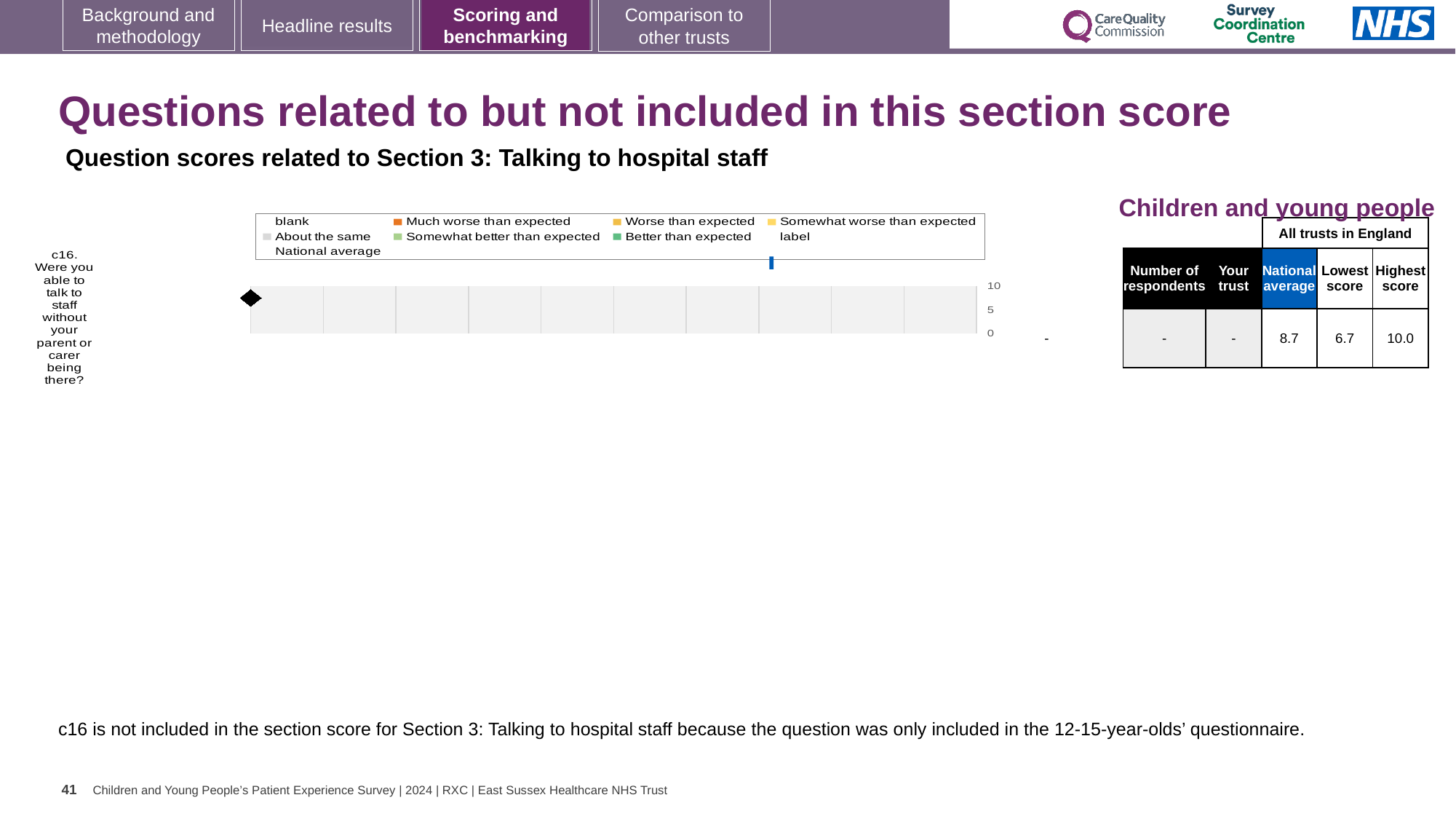
Which question is shown on the chart's category axis? c16. Were you able to talk to staff without your parent or carer being there? What is the highest value shown on the chart's value axis? 10 In the table next to the chart, what is the difference between the Highest score and the Lowest score for c16? 3.3 Which legend entry is shown with an orange marker? Much worse than expected In the table next to the chart, what is the Lowest score for c16? 6.7 In the table next to the chart, what is the National average score for c16? 8.7 In the table next to the chart, is the National average for c16 greater or less than 5? greater In the table next to the chart, what is the Highest score for c16? 10.0 How many questions (categories) are plotted on the chart? 1 In the table next to the chart, what is shown for Your trust score for c16? - What kind of chart is shown on the slide? bar chart